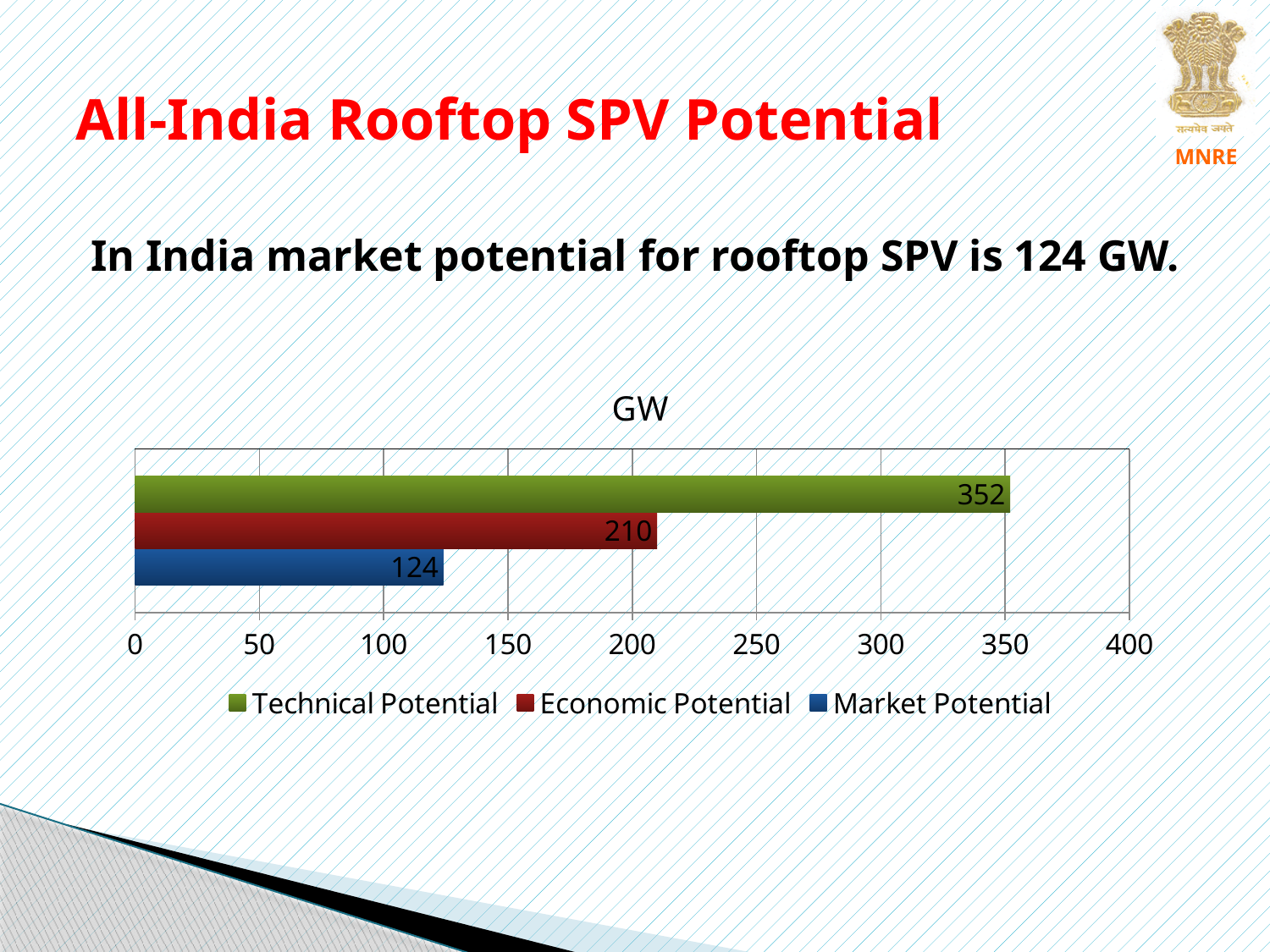
What is the value for Technical Potential? 352 What is the value for Market Potential? 124 What kind of chart is shown on the slide? bar chart Which series has the highest value? Technical Potential What is the difference between Technical Potential and Market Potential? 228 How many series does the legend list? 3 Which is larger, Economic Potential or Market Potential? Economic Potential What is the difference between Economic Potential and Market Potential? 86 What is the value for Economic Potential? 210 What is the title of the chart? GW Is the value for Technical Potential greater or less than 300? greater Which series has the lowest value? Market Potential